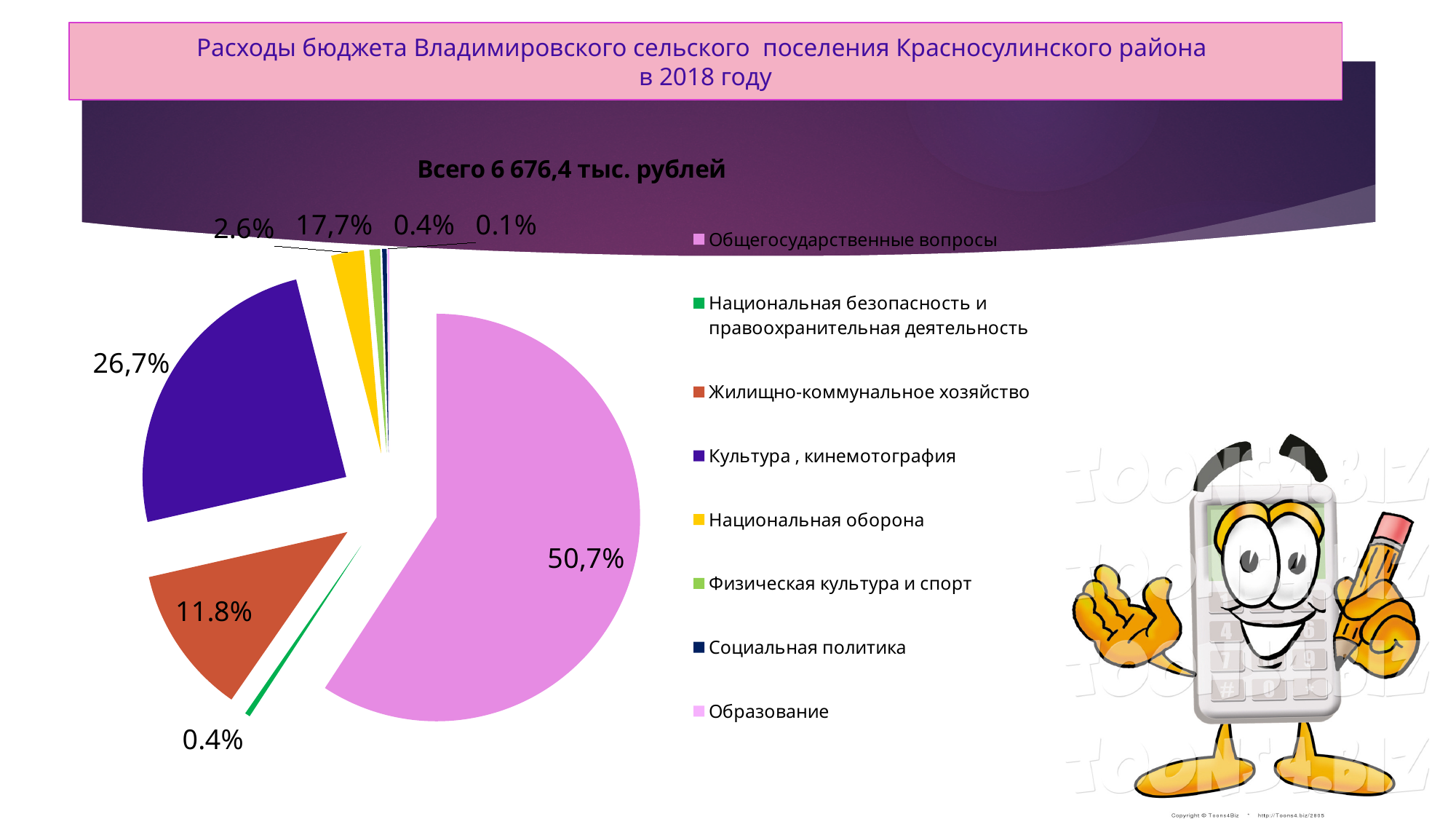
What is the value shown for Жилищно-коммунальное хозяйство? 11.8% What kind of chart is shown on the slide? pie chart Which category has the largest slice of the pie? Общегосударственные вопросы What is the difference between the shares of Общегосударственные вопросы and Культура , кинемотография? 24,0% Is the share for Общегосударственные вопросы greater or less than 50%? greater What is the value shown for Культура , кинемотография? 26,7% Which colour represents Национальная оборона in the legend? yellow What total amount is stated above the chart? Всего 6 676,4 тыс. рублей What share of the pie does Общегосударственные вопросы take? 50,7% How many categories does the legend list? 8 Which is larger: Культура , кинемотография or Жилищно-коммунальное хозяйство? Культура , кинемотография